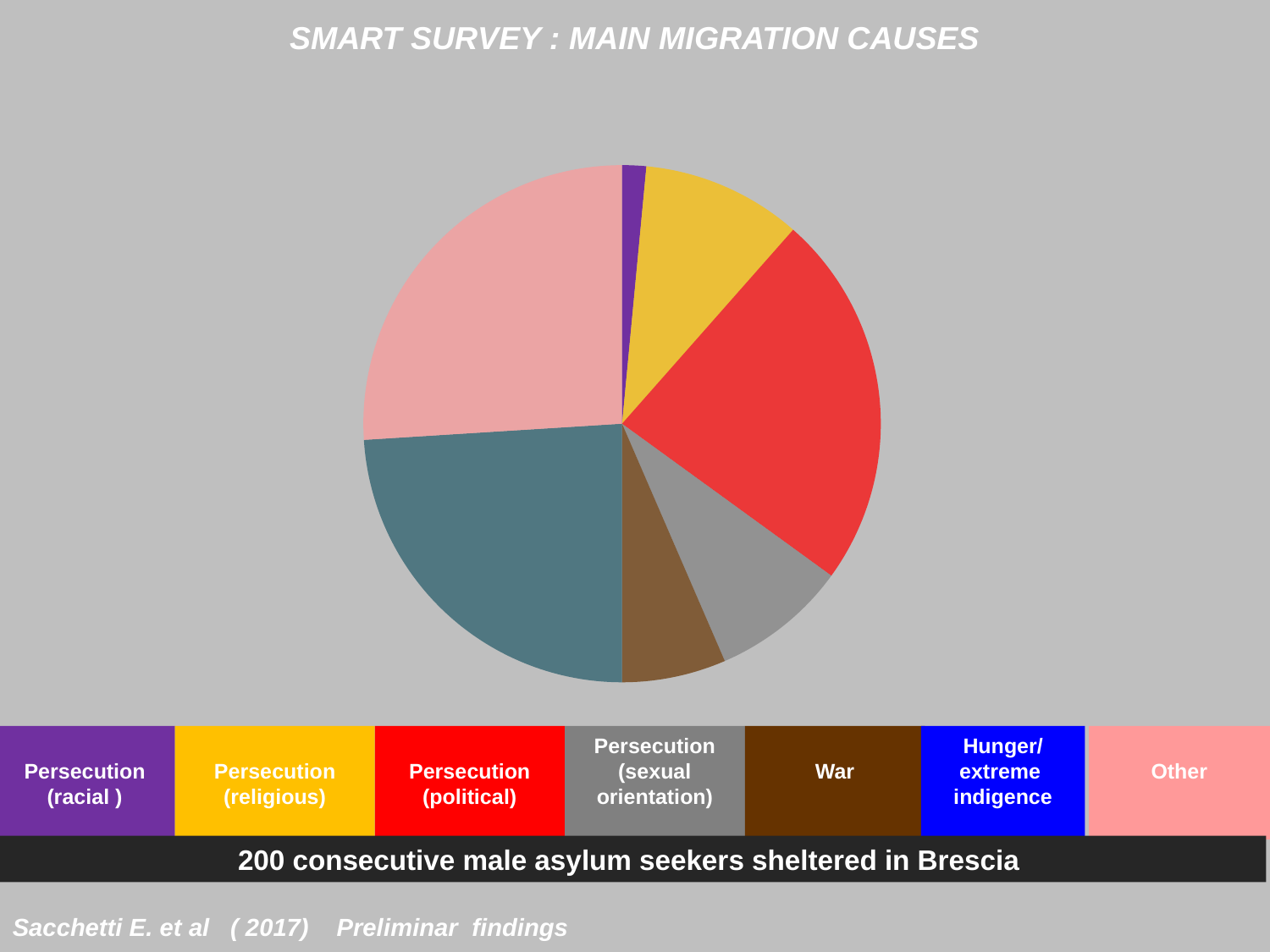
Which slice is larger: Persecution (political) or Persecution (religious)? Persecution (political) What kind of chart is shown on the slide? pie chart Which slice is larger: War or Persecution (religious)? Persecution (religious) Which slice is larger: Hunger/extreme indigence or Persecution (sexual orientation)? Hunger/extreme indigence How many asylum seekers does the slide say were surveyed? 200 How many migration cause categories does the pie chart show? 7 Which migration cause has the smallest slice of the pie? Persecution (racial) What is the title of the chart? SMART SURVEY : MAIN MIGRATION CAUSES